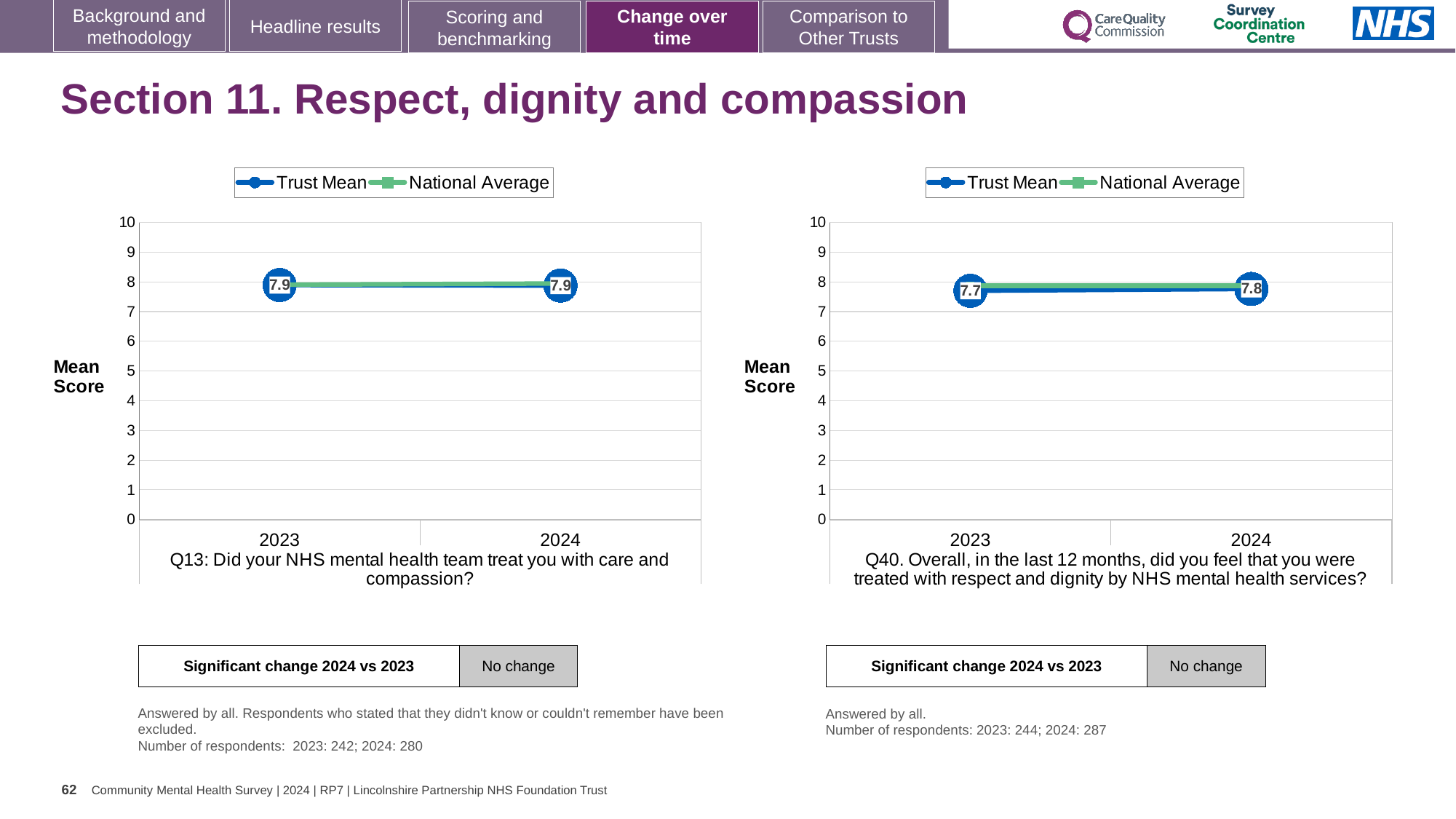
In the right chart (Q40), what is the Trust Mean value for 2024? 7.8 How many series does the legend of the left chart (Q13) list? 2 What kind of chart is the left chart (Q13)? line chart In the right chart (Q40), is the Trust Mean for 2024 greater or less than 9? less In the left chart (Q13), is the Trust Mean for 2023 greater or less than 5? greater In the left chart (Q13), what is the Trust Mean value for 2023? 7.9 How many years are plotted on the x axis of the right chart (Q40)? 2 In the left chart (Q13), what is the Trust Mean value for 2024? 7.9 In the right chart (Q40), what is the difference between the Trust Mean in 2024 and in 2023? 0.1 In the right chart (Q40), does the Trust Mean rise or fall from 2023 to 2024? rise In the right chart (Q40), what is the Trust Mean value for 2023? 7.7 What are the two series named in the legend of the right chart (Q40)? Trust Mean and National Average